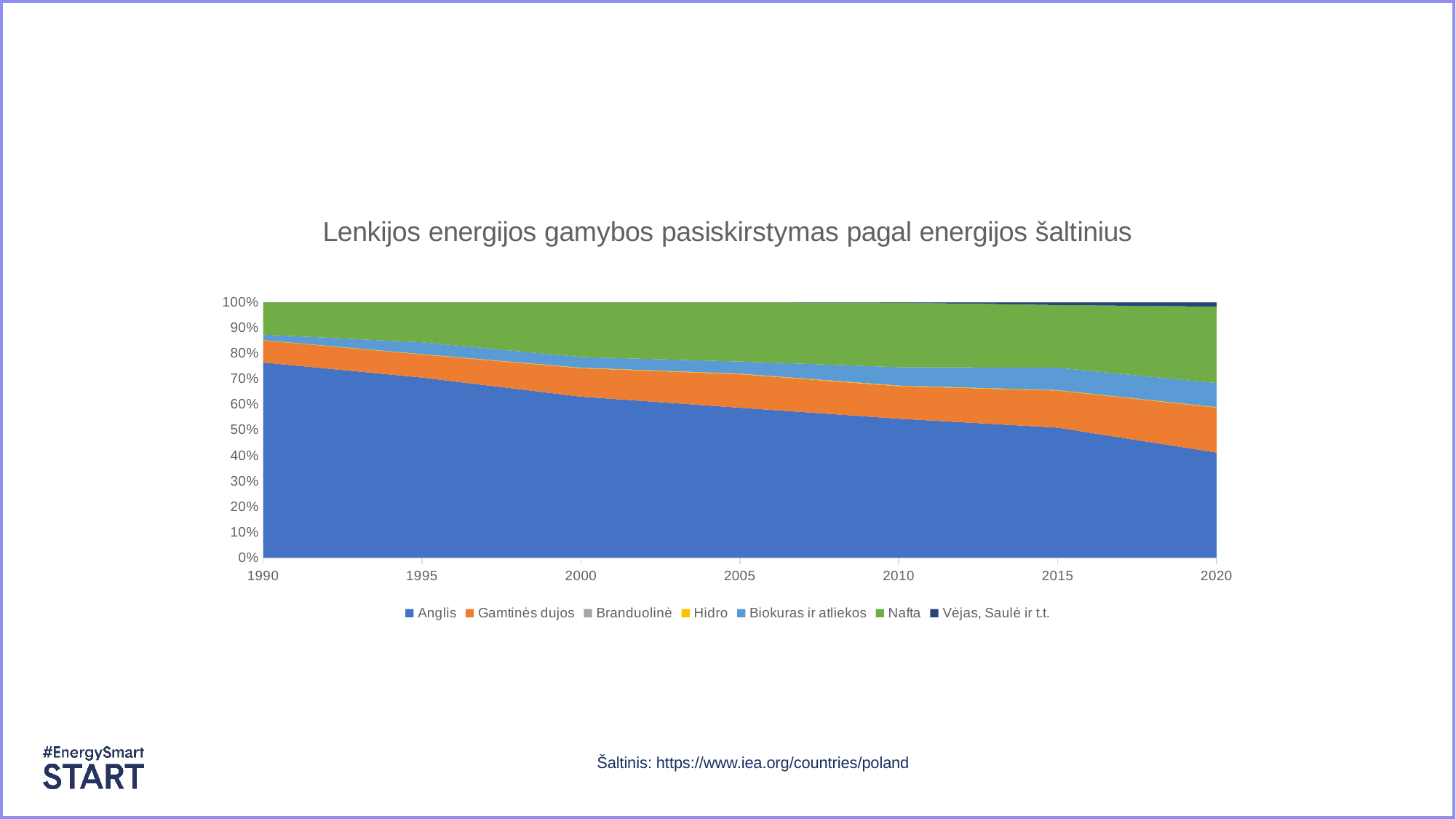
In 2020, which has the larger share, Anglis or Nafta? Anglis What is the title of the chart? Lenkijos energijos gamybos pasiskirstymas pagal energijos šaltinius Which series is listed first in the chart legend? Anglis Does the share of Anglis rise or fall from 1990 to 2020? Fall How many series does the chart legend list? 7 How many years are labelled on the x axis? 7 Is the share of Anglis in 1990 greater or less than 70%? greater Is the share of Anglis in 2020 greater or less than 50%? less Does the share of Nafta rise or fall from 1990 to 2020? Rise What kind of chart is shown on the slide? Stacked area chart What is the first year shown on the x axis? 1990 Which energy source has the largest share in 1990? Anglis